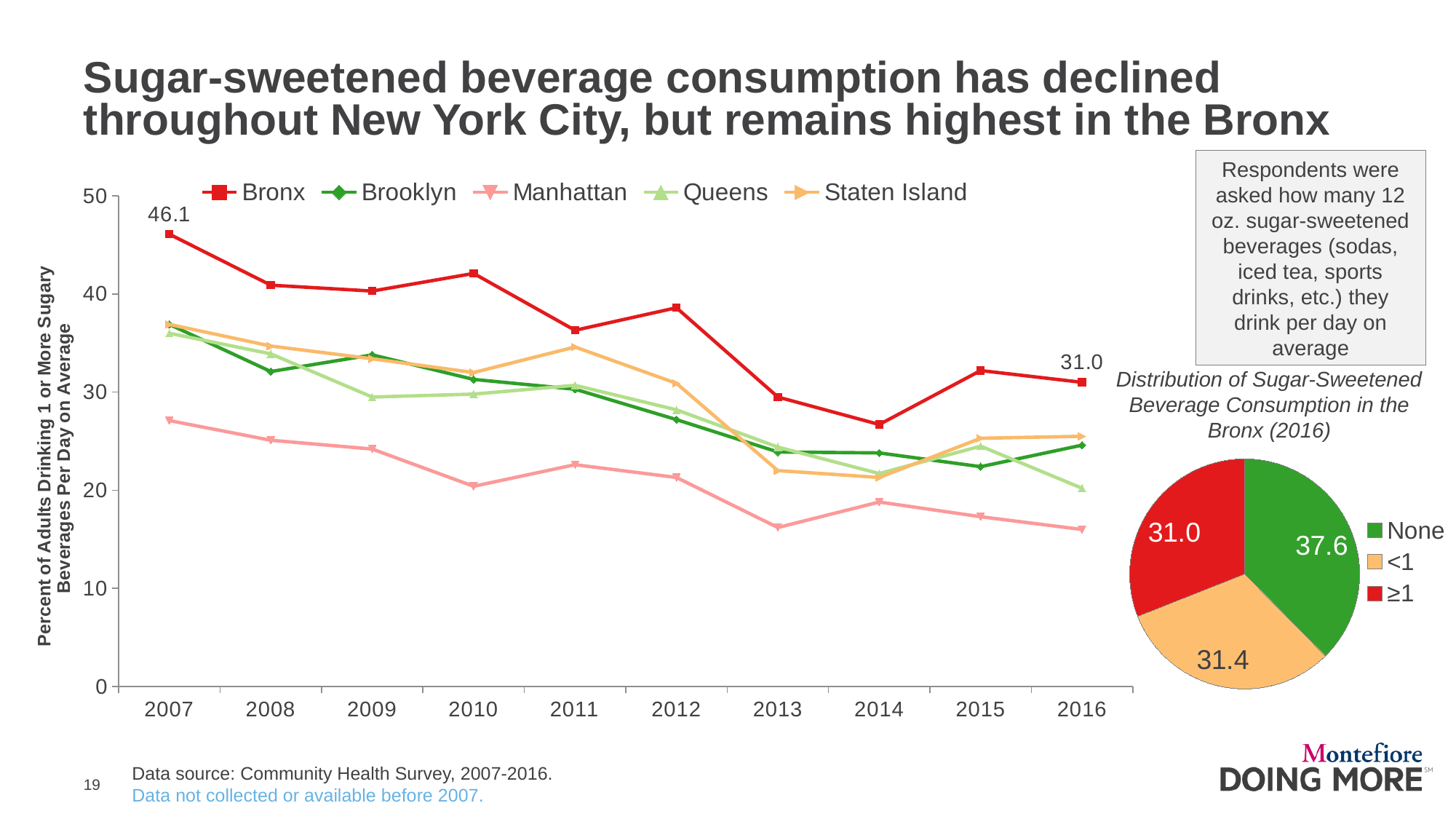
In the line chart, is the value for Manhattan in 2007 greater or less than 30? less In the pie chart 'Distribution of Sugar-Sweetened Beverage Consumption in the Bronx (2016)', what is the value for '<1'? 31.4 In the line chart, which borough has the highest value in 2016? Bronx In the line chart, which is larger in 2016: Brooklyn or Queens? Brooklyn In the line chart, does the Bronx series generally rise or fall from 2007 to 2016? Fall How many series does the legend of the line chart list? 5 What kind of chart is the chart on the left of the slide? Line chart In the line chart, what is the value for the Bronx in 2016? 31.0 In the line chart, which borough has the lowest value in 2016? Manhattan In the line chart, what is the value for the Bronx in 2007? 46.1 In the line chart, by how much did the Bronx value fall from 2007 to 2016? 15.1 In the pie chart 'Distribution of Sugar-Sweetened Beverage Consumption in the Bronx (2016)', which category has the largest slice? None